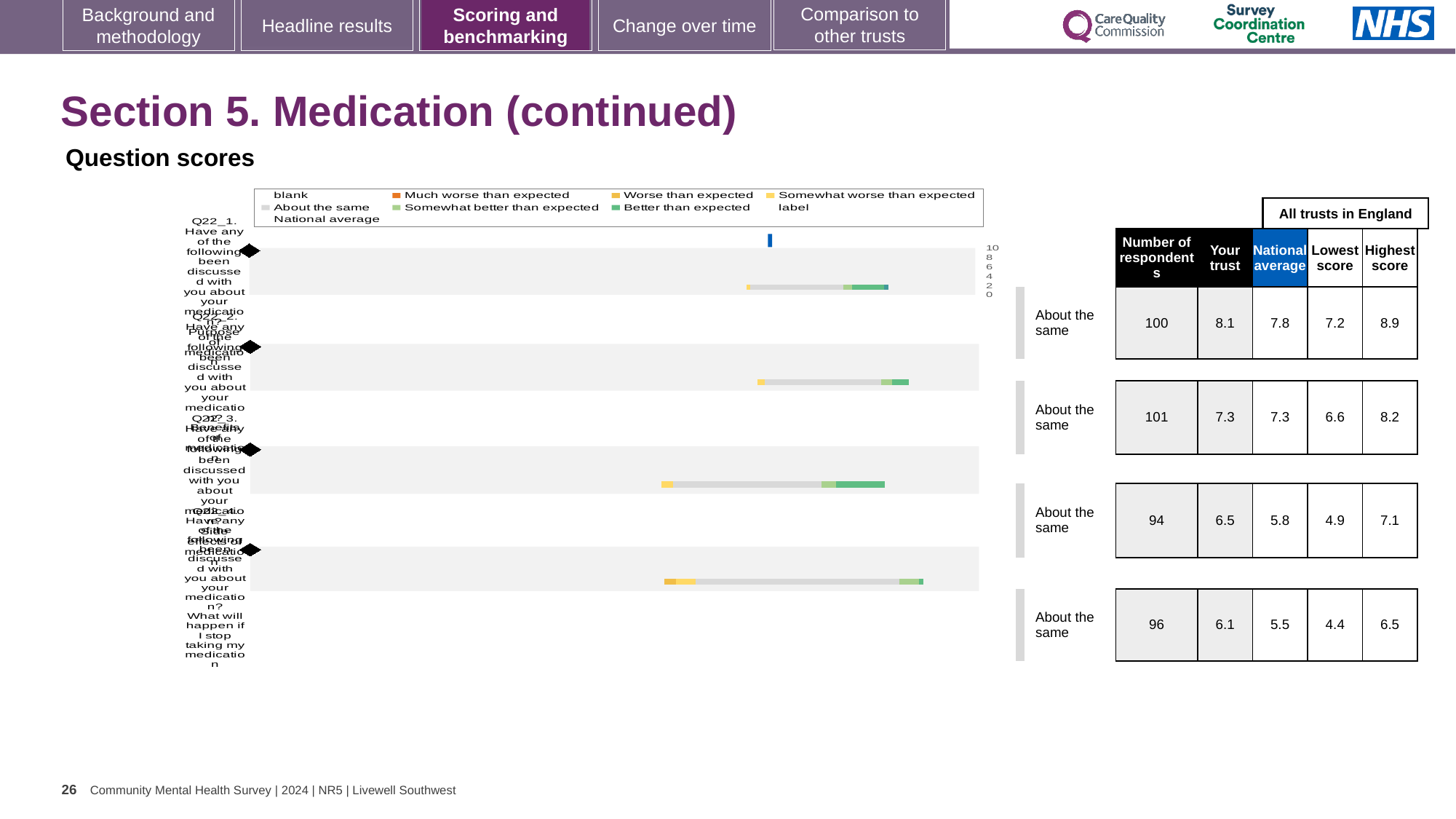
How many entries does the chart legend list? 9 In the table beside the chart, which question row has the lowest 'Lowest score'? the fourth row (4.4) In the table beside the chart, what is the 'Your trust' score for the first question row? 8.1 In the table beside the chart, what is the difference between 'Your trust' and the National average for the third question row? 0.7 In the table beside the chart, what is the National average for the third question row? 5.8 Which legend entry is shown in dark green? Better than expected What kind of chart is shown on the slide? bar chart In the table beside the chart, is 'Your trust' or the National average larger for the second question row? they are equal (7.3) How many question rows (diamond markers) are plotted in the chart? 4 What is the highest value shown on the chart's axis? 10 In the table beside the chart, what is the Highest score for the fourth question row? 6.5 In the table beside the chart, which question row has the highest 'Your trust' score? the first row (8.1)